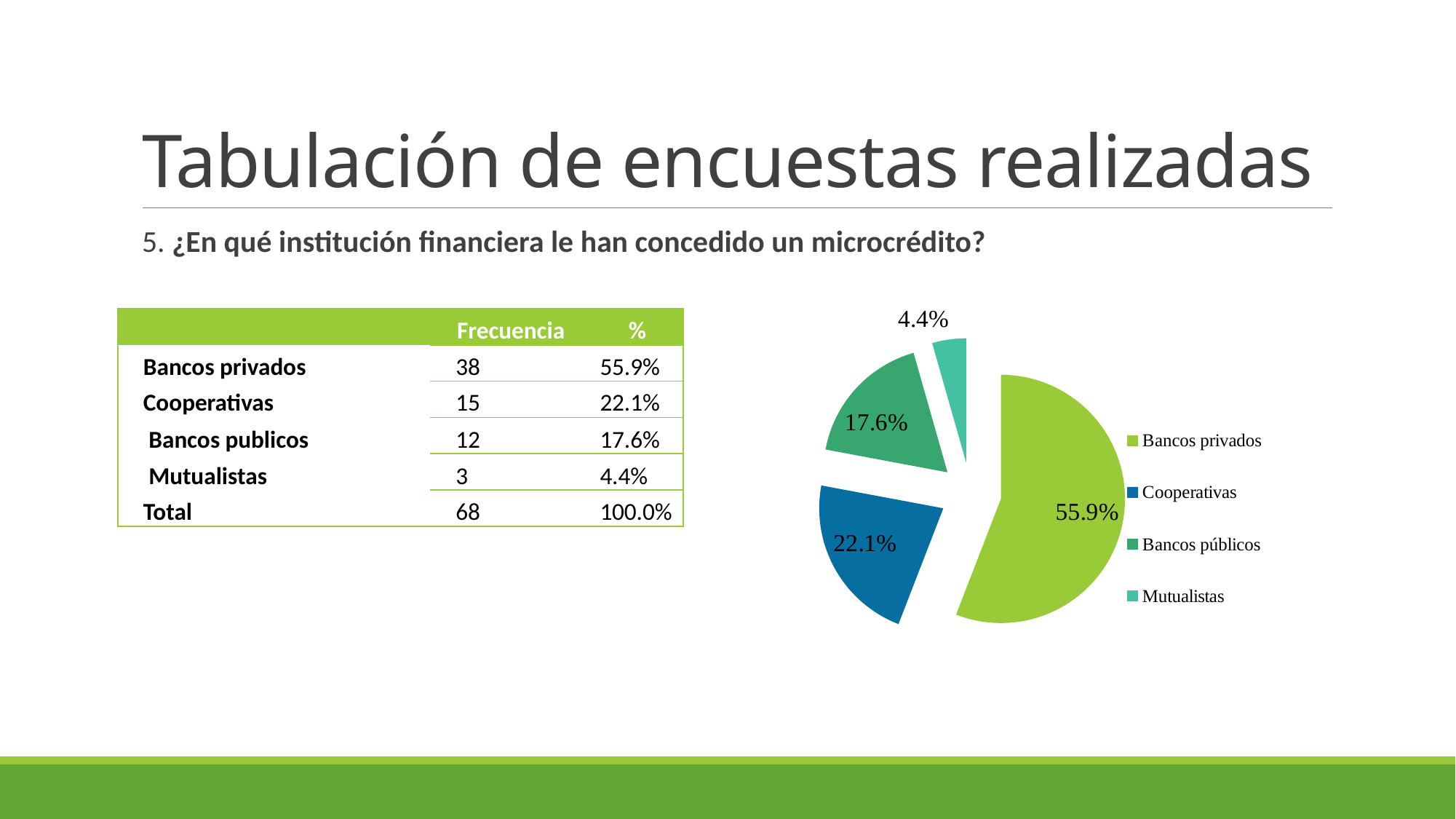
Which is larger, the slice for Cooperativas or the slice for Bancos públicos? Cooperativas What share of the pie does Cooperativas represent? 22.1% How many slices does the pie chart have? 4 What share of the pie does Mutualistas represent? 4.4% What share of the pie does Bancos públicos represent? 17.6% Which category has the smallest slice of the pie? Mutualistas What kind of chart is shown on the slide? pie chart How many entries does the legend list? 4 What is the difference in percentage points between Bancos privados and Cooperativas? 33.8 What colour is the Cooperativas slice in the pie chart? dark blue Which category has the largest slice of the pie? Bancos privados